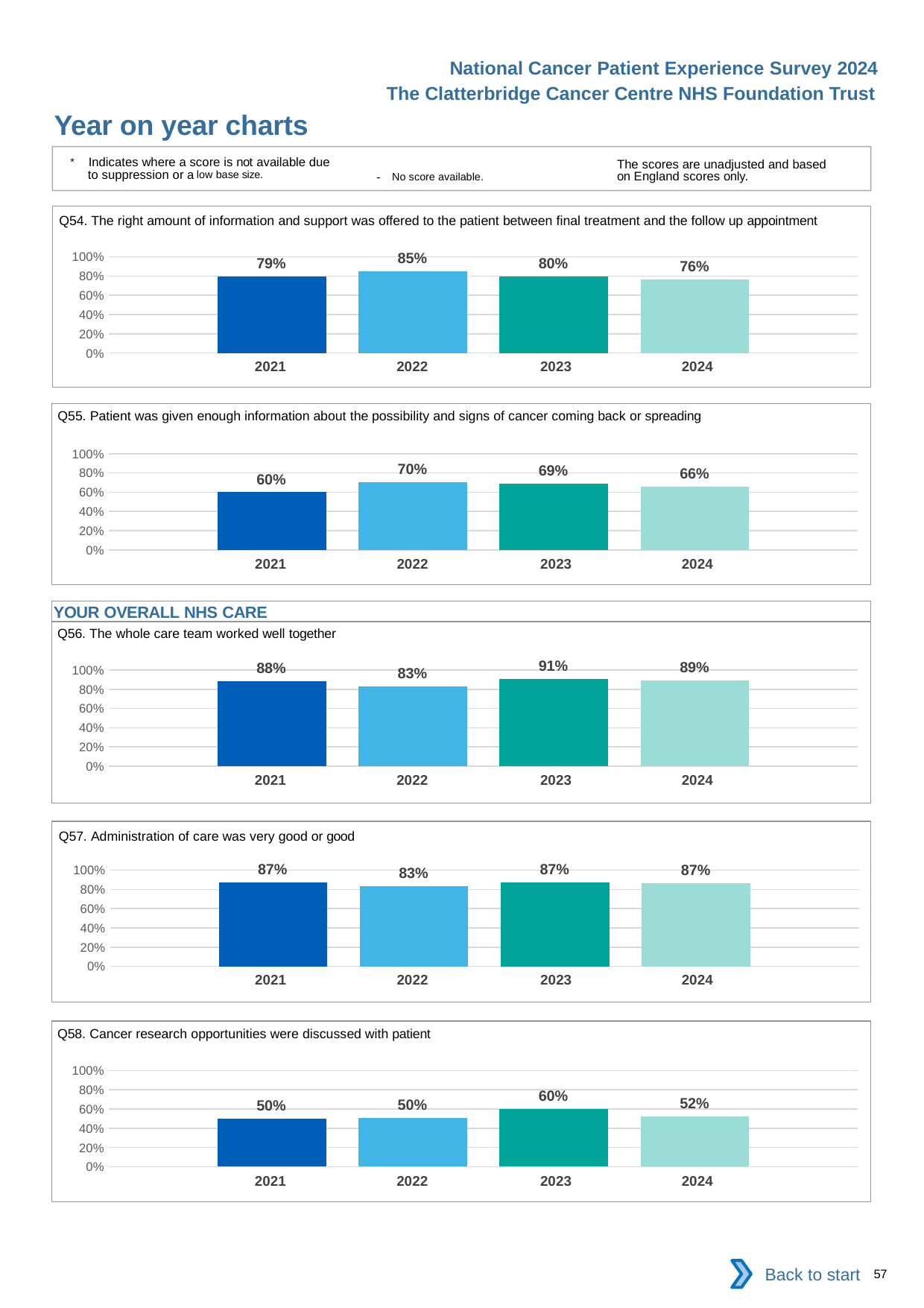
In the Q58 chart, what is the difference between the 2023 value and the 2024 value? 8% What is the section heading shown above the Q56 chart? YOUR OVERALL NHS CARE What kind of chart is the Q58 chart? bar chart In the Q54 chart, what is the value for 2022? 85% In the Q56 chart, what is the difference between the 2021 value and the 2022 value? 5% In the Q55 chart, which year has the lowest value? 2021 In the Q57 chart, what is the value for 2022? 83% In the Q56 chart, which year has the highest value? 2023 In the Q58 chart, what is the value for 2021? 50% In the Q54 chart, is the value for 2024 greater or less than 80%? less In the Q55 chart, is the value for 2022 or 2024 larger? 2022 In the Q54 chart, how many years are plotted? 4